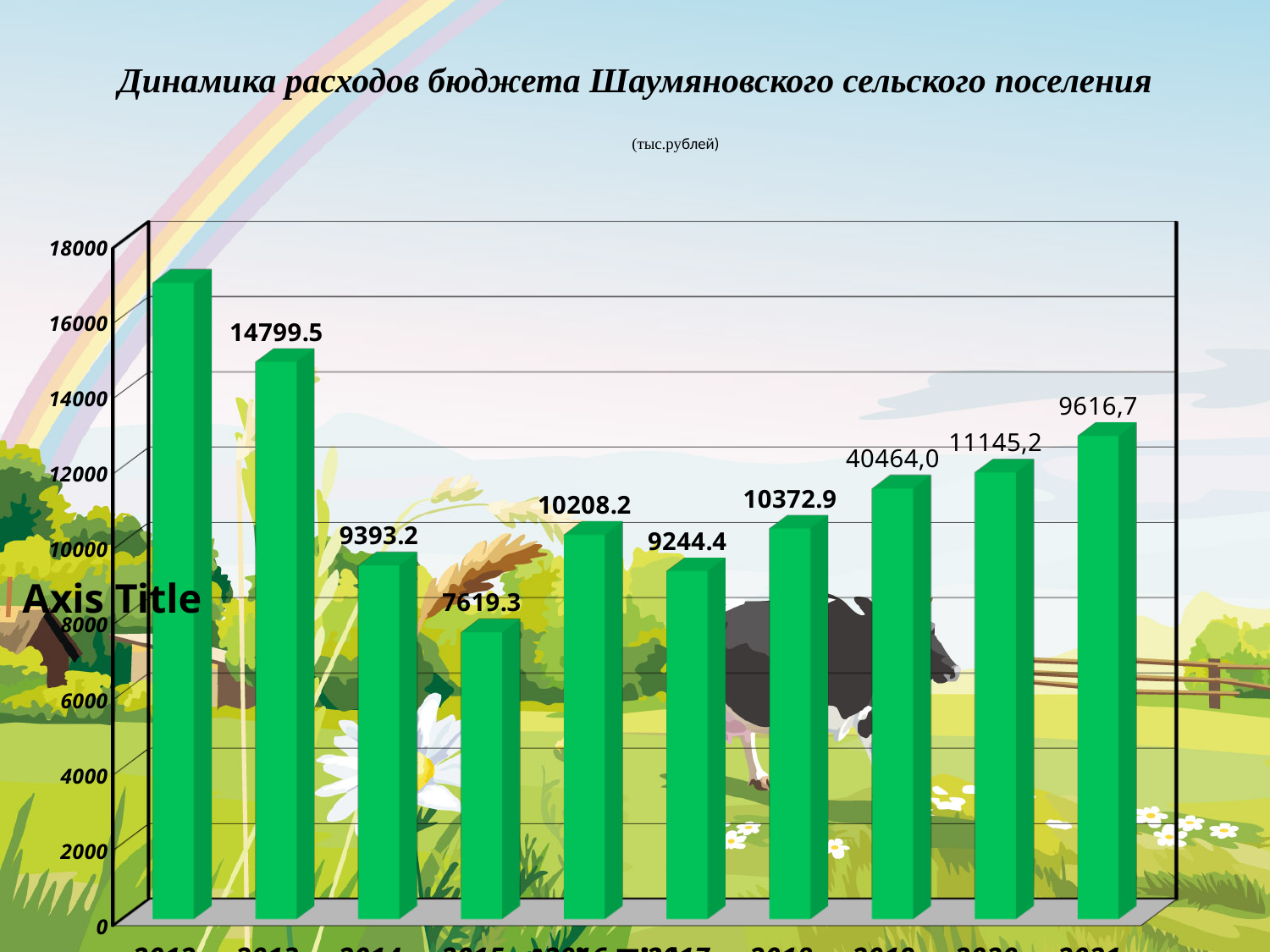
What is the difference between the second bar (14799.5) and the third bar (9393.2)? 5406.3 What unit is given under the chart title? тыс.рублей Which is larger, the fifth bar (10208.2) or the sixth bar (9244.4)? the fifth bar (10208.2) What is the value shown on the rightmost bar? 9616,7 How many bars are plotted in the chart? 10 Is the value of the leftmost bar greater or less than 16000? greater Which bar has the lowest value in the chart? the fourth bar from the left (7619.3) What kind of chart is shown on the slide? bar chart What is the value shown on the fourth bar from the left? 7619.3 What is the value shown on the seventh bar from the left? 10372.9 What is the value shown on the second bar from the left? 14799.5 Do the values rise or fall from the second bar to the fourth bar? fall